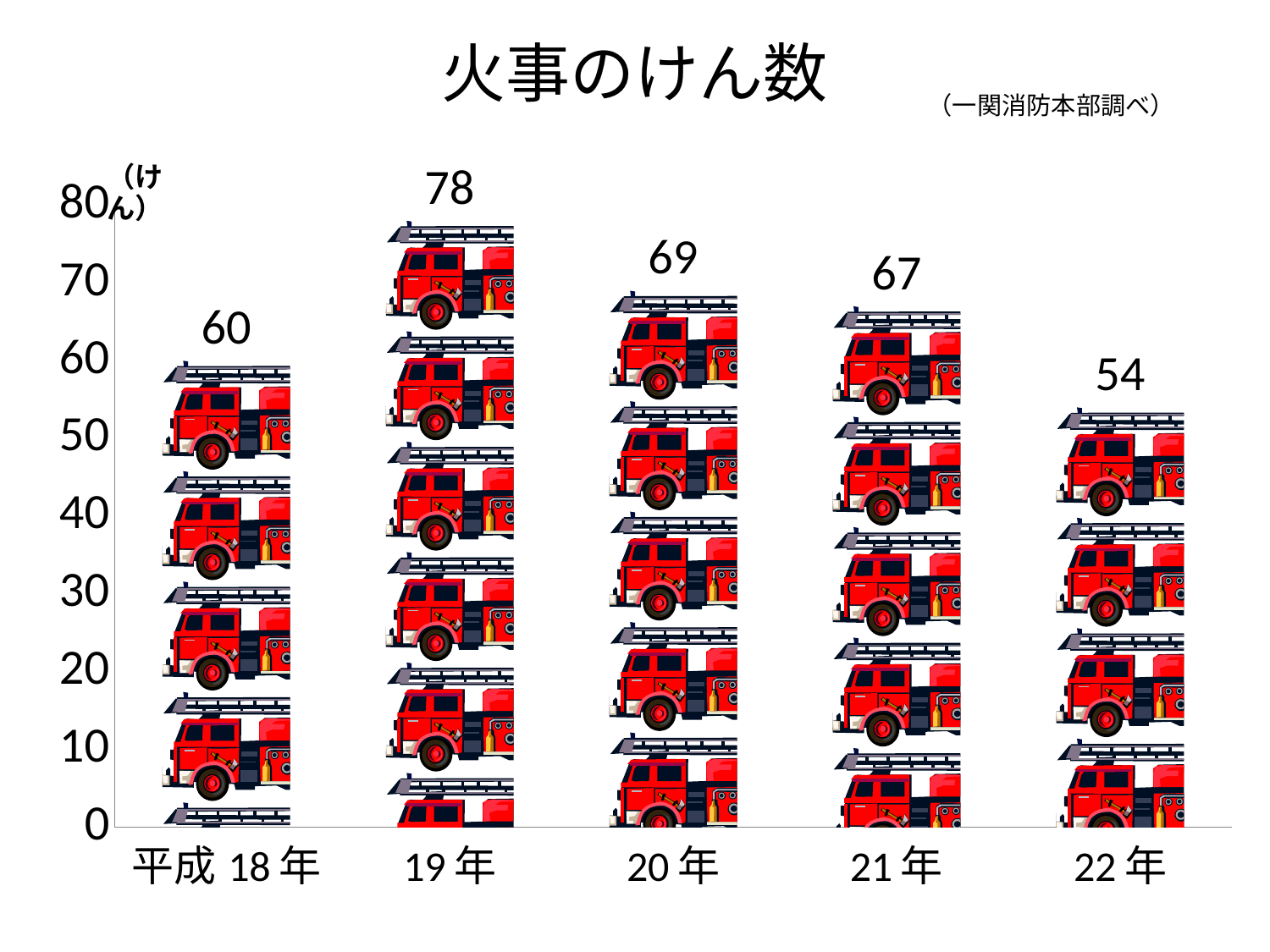
What is the value for 19年? 78 Is the value for 21年 greater or less than 60? greater What is the difference between the values for 20年 and 21年? 2 Which is larger, the value for 平成18年 or the value for 20年? 20年 What is the title of the chart? 火事のけん数 How many years are shown on the x axis? 5 What is the value for 平成18年? 60 What kind of chart is this? bar chart (pictograph with fire trucks) Which year has the highest number of fires? 19年 What is the difference between the values for 19年 and 22年? 24 Which year has the lowest number of fires? 22年 What is the value for 22年? 54